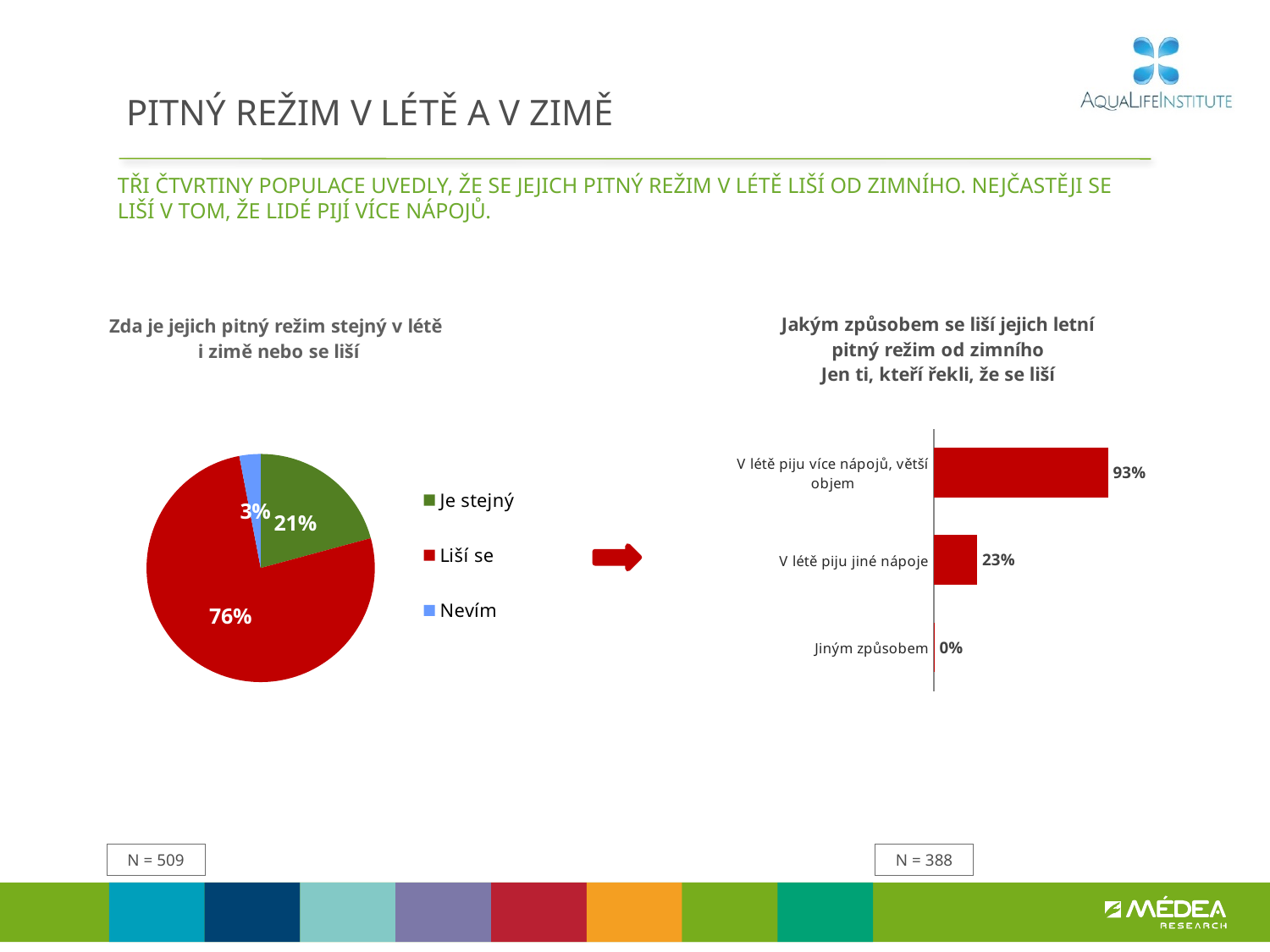
In the bar chart on the right, what is the value for "V létě piju více nápojů, větší objem"? 93% What type of chart is the chart on the right side of the slide? Bar chart In the pie chart on the left, what is the difference in percentage points between "Liší se" and "Je stejný"? 55 In the pie chart on the left, what share of respondents answered "Je stejný"? 21% In the bar chart on the right, what is the value for "Jiným způsobem"? 0% In the pie chart on the left, how many entries does the legend list? 3 In the bar chart on the right, what is the value for "V létě piju jiné nápoje"? 23% In the pie chart on the left, which category has the largest slice? Liší se In the pie chart on the left, what share of respondents answered "Nevím"? 3% In the pie chart on the left, what share of respondents answered "Liší se"? 76% In the bar chart on the right, how many categories are shown? 3 In the pie chart on the left, which category has the smallest slice? Nevím